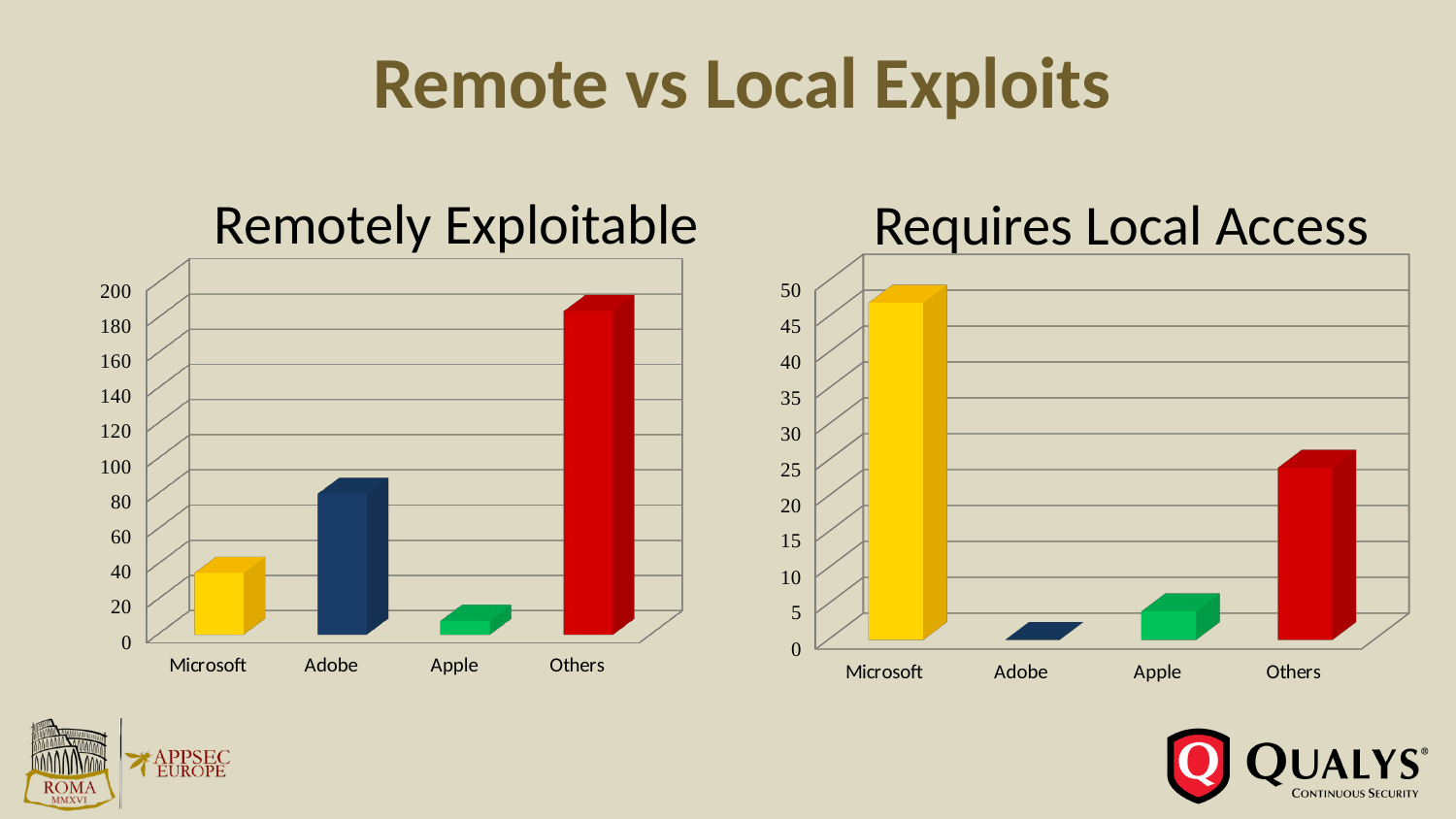
In the "Remotely Exploitable" chart, which category has the highest value? Others In the "Remotely Exploitable" chart, which is larger, the value for Microsoft or the value for Adobe? Adobe In the "Remotely Exploitable" chart, which category has the lowest value? Apple In the "Remotely Exploitable" chart, is the value for Others greater or less than 160? greater In the "Remotely Exploitable" chart, is the value for Adobe greater or less than 100? less In the "Requires Local Access" chart, which is larger, the value for Apple or the value for Others? Others In the "Requires Local Access" chart, which category has the highest value? Microsoft What kind of chart is the "Remotely Exploitable" chart? bar chart What is the title of the chart on the right side of the slide? Requires Local Access How many categories are shown in the "Remotely Exploitable" chart? 4 In the "Requires Local Access" chart, which category has the lowest value? Adobe In the "Requires Local Access" chart, is the value for Microsoft greater or less than 40? greater